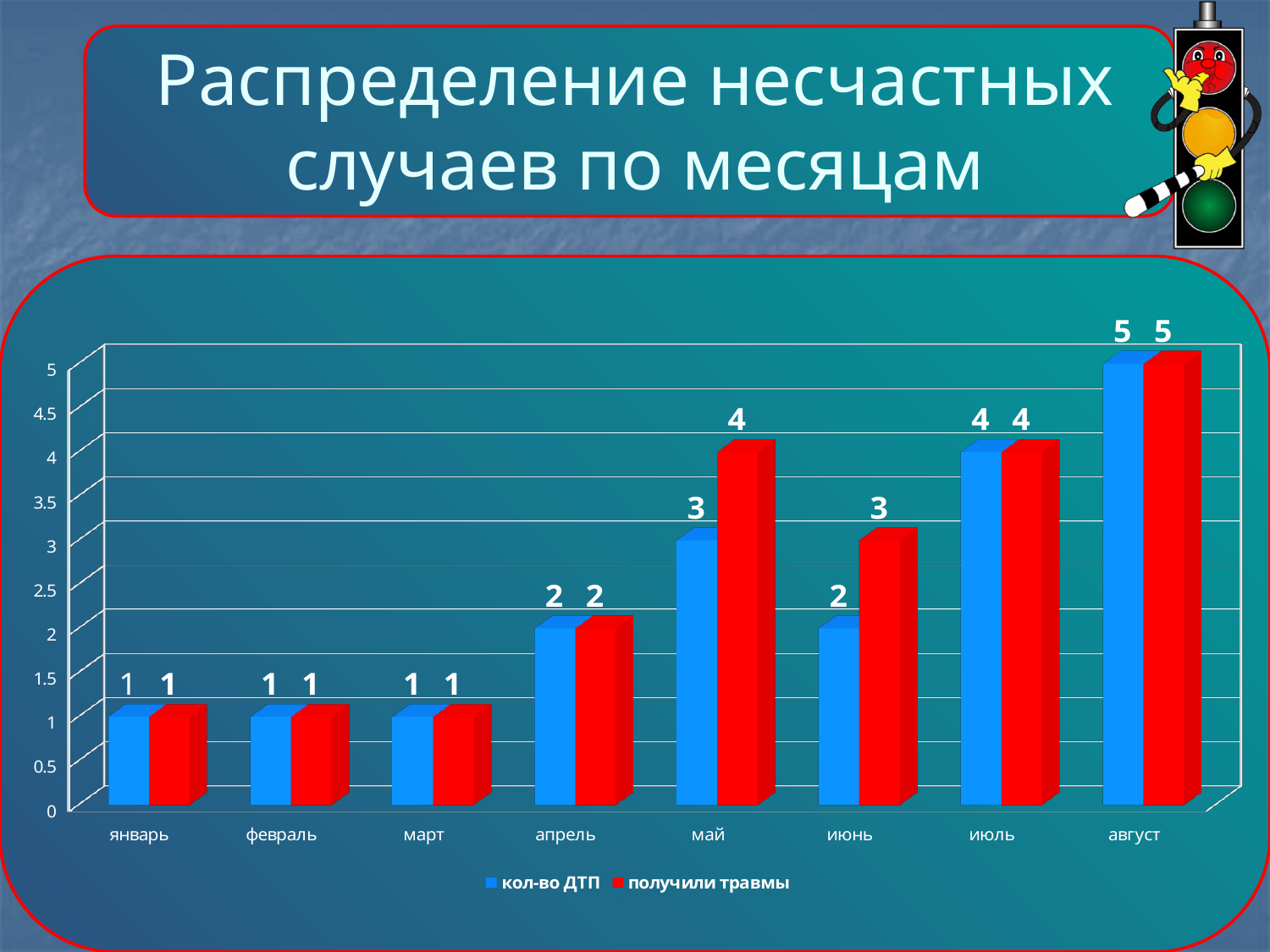
Which colour represents получили травмы in the chart? red How many months are shown on the x axis? 8 What is the value of получили травмы for май? 4 Which month has the highest value for кол-во ДТП? август How many series does the legend list? 2 Which is larger for июнь: кол-во ДТП or получили травмы? получили травмы What is the difference between получили травмы and кол-во ДТП for май? 1 What is the difference in кол-во ДТП between август and апрель? 3 What is the value of кол-во ДТП for май? 3 What is the value of получили травмы for июнь? 3 Do the values for кол-во ДТП generally rise or fall from январь to август? rise What kind of chart is shown on the slide? bar chart